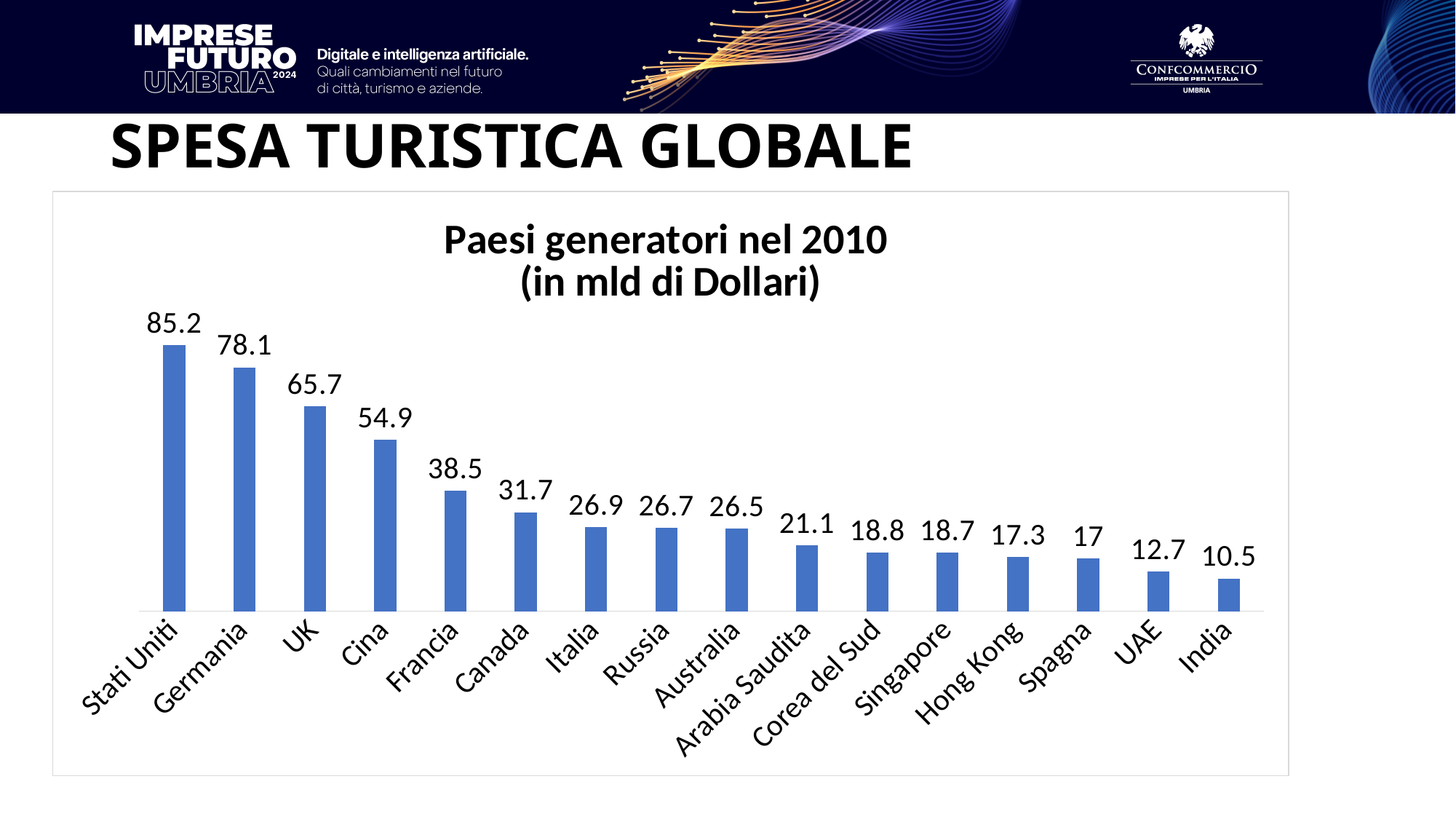
Which country has the lowest value? India What is the title of the chart? Paesi generatori nel 2010 (in mld di Dollari) Do the values rise or fall from left to right along the x axis? Fall What is the value for Francia? 38.5 Which is larger, the value for Canada or the value for Italia? Canada Which country has the highest value? Stati Uniti What kind of chart is this? Bar chart What is the difference between the values for Stati Uniti and Germania? 7.1 What is the value for Arabia Saudita? 21.1 What is the value for Germania? 78.1 What is the difference between the values for UK and Cina? 10.8 How many countries are shown in the chart? 16